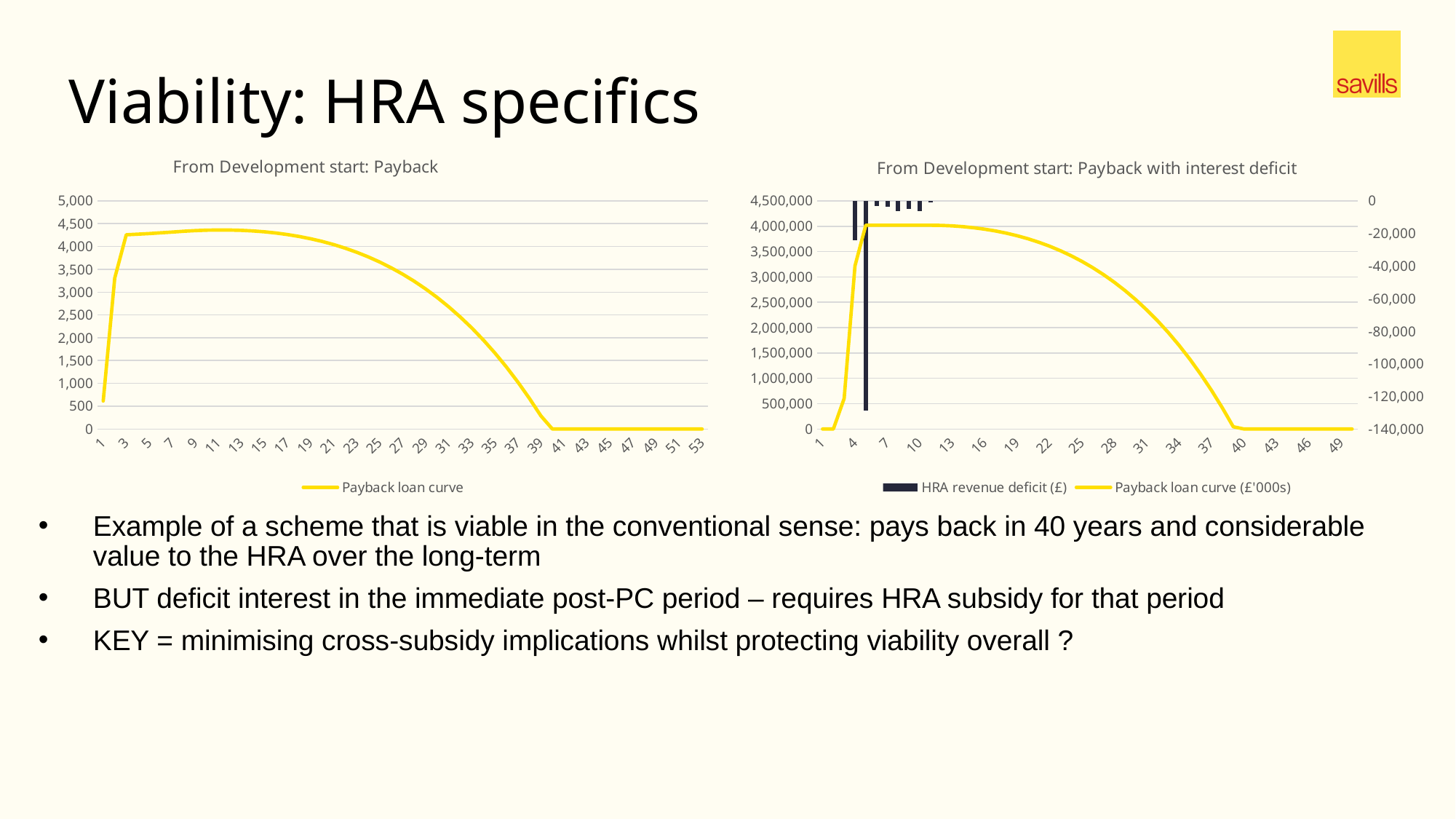
How many series does the legend of the right chart 'From Development start: Payback with interest deficit' list? 2 In the right chart 'From Development start: Payback with interest deficit', which series is shown as bars? HRA revenue deficit (£) In the left chart 'From Development start: Payback', is the value of the Payback loan curve at year 1 greater or less than 1,000? less How many series does the legend of the left chart 'From Development start: Payback' list? 1 In the left chart 'From Development start: Payback', is the value of the Payback loan curve at year 11 greater or less than 4,000? greater In the right chart 'From Development start: Payback with interest deficit', is the Payback loan curve value at year 10 greater or less than 3,500,000 on the left axis? greater What is the title of the right chart? From Development start: Payback with interest deficit In the right chart 'From Development start: Payback with interest deficit', does the Payback loan curve rise or fall between year 10 and year 37? fall In the left chart 'From Development start: Payback', does the Payback loan curve rise or fall between year 13 and year 39? fall What kind of chart is the left chart titled 'From Development start: Payback'? line chart